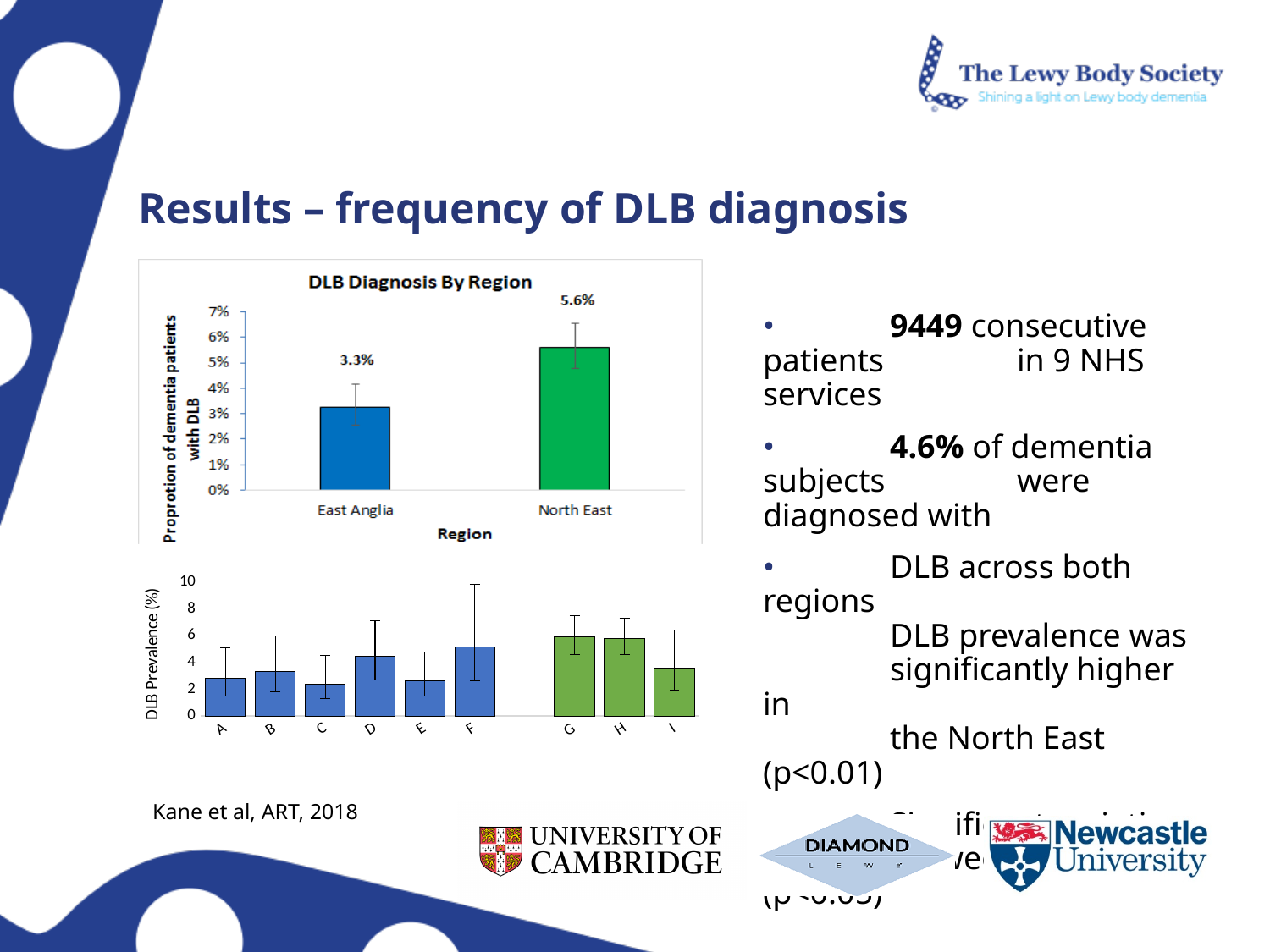
In the 'DLB Diagnosis By Region' chart, what is the difference between the North East and East Anglia values? 2.3% In the bottom chart showing DLB Prevalence (%), what is the label of the y axis? DLB Prevalence (%) In the bottom chart showing DLB Prevalence (%), how many services (categories) are plotted on the x axis? 9 In the 'DLB Diagnosis By Region' chart, what is the proportion of dementia patients with DLB in East Anglia? 3.3% In the bottom chart showing DLB Prevalence (%), is the value for service C greater or less than 4? less In the 'DLB Diagnosis By Region' chart, which region has the higher proportion of dementia patients with DLB? North East What kind of chart is the 'DLB Diagnosis By Region' chart? Bar chart In the bottom chart showing DLB Prevalence (%), is the value for service G larger than the value for service A? Yes In the 'DLB Diagnosis By Region' chart, what is the proportion of dementia patients with DLB in the North East? 5.6% In the 'DLB Diagnosis By Region' chart, what is the label of the y axis? Proprotion of dementia patients with DLB In the 'DLB Diagnosis By Region' chart, how many regions are plotted? 2 In the bottom chart showing DLB Prevalence (%), is the value for service G greater or less than 4? greater